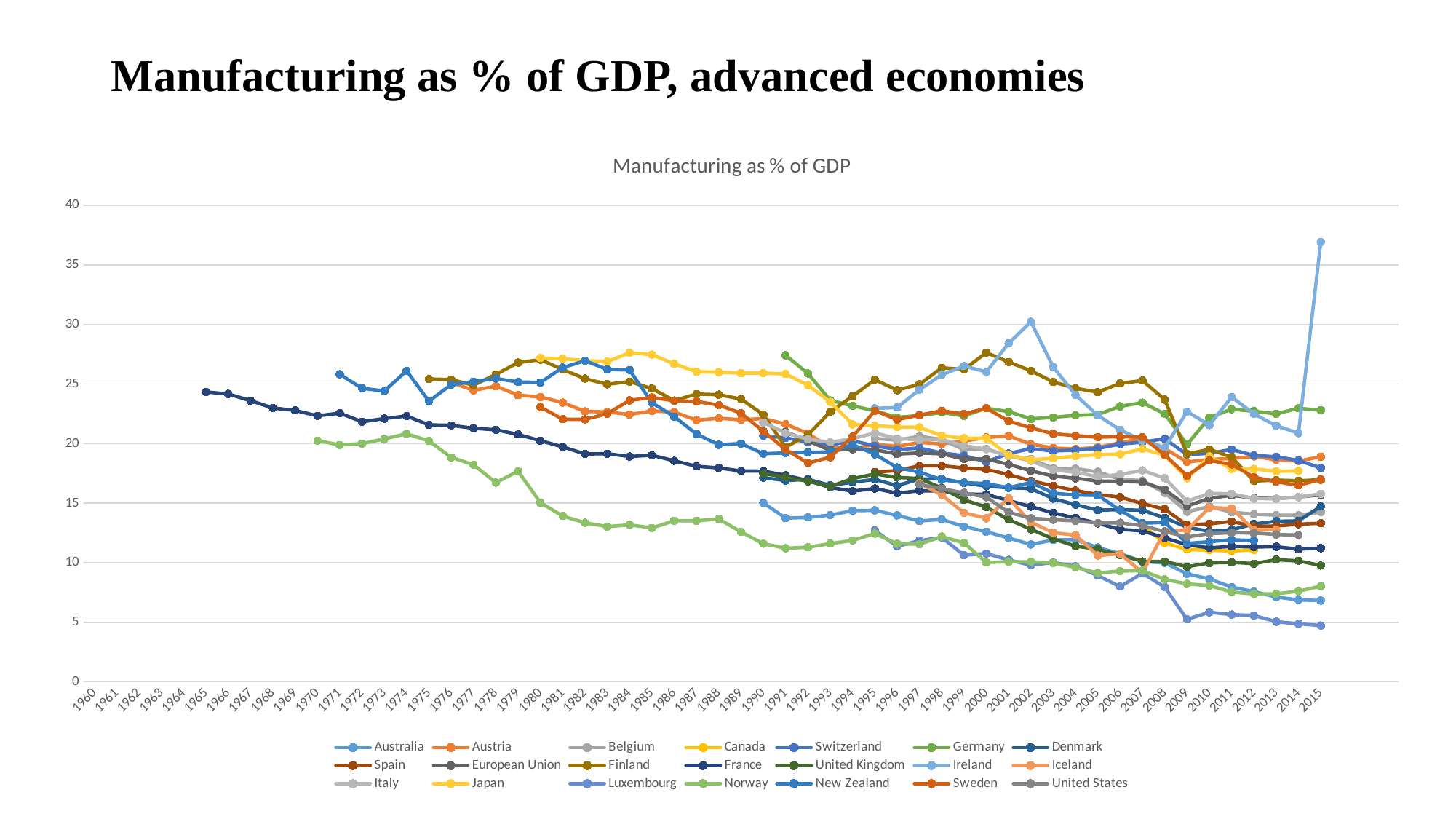
Does the value for France rise or fall from 1965 to 2015? fall Is the highest value plotted for 2015 greater or less than 35? greater Does the value for Norway rise or fall from 1970 to 2015? fall What kind of chart is shown on the slide? line chart Is the value for Germany in 2015 greater or less than 20? greater How many years are plotted along the x axis? 56 How many series does the legend list? 21 Is the value for Norway in 2015 greater or less than 10? less What is the title of the chart? Manufacturing as % of GDP What is the first year shown on the x axis? 1960 Which series has the highest value in 2015? Ireland